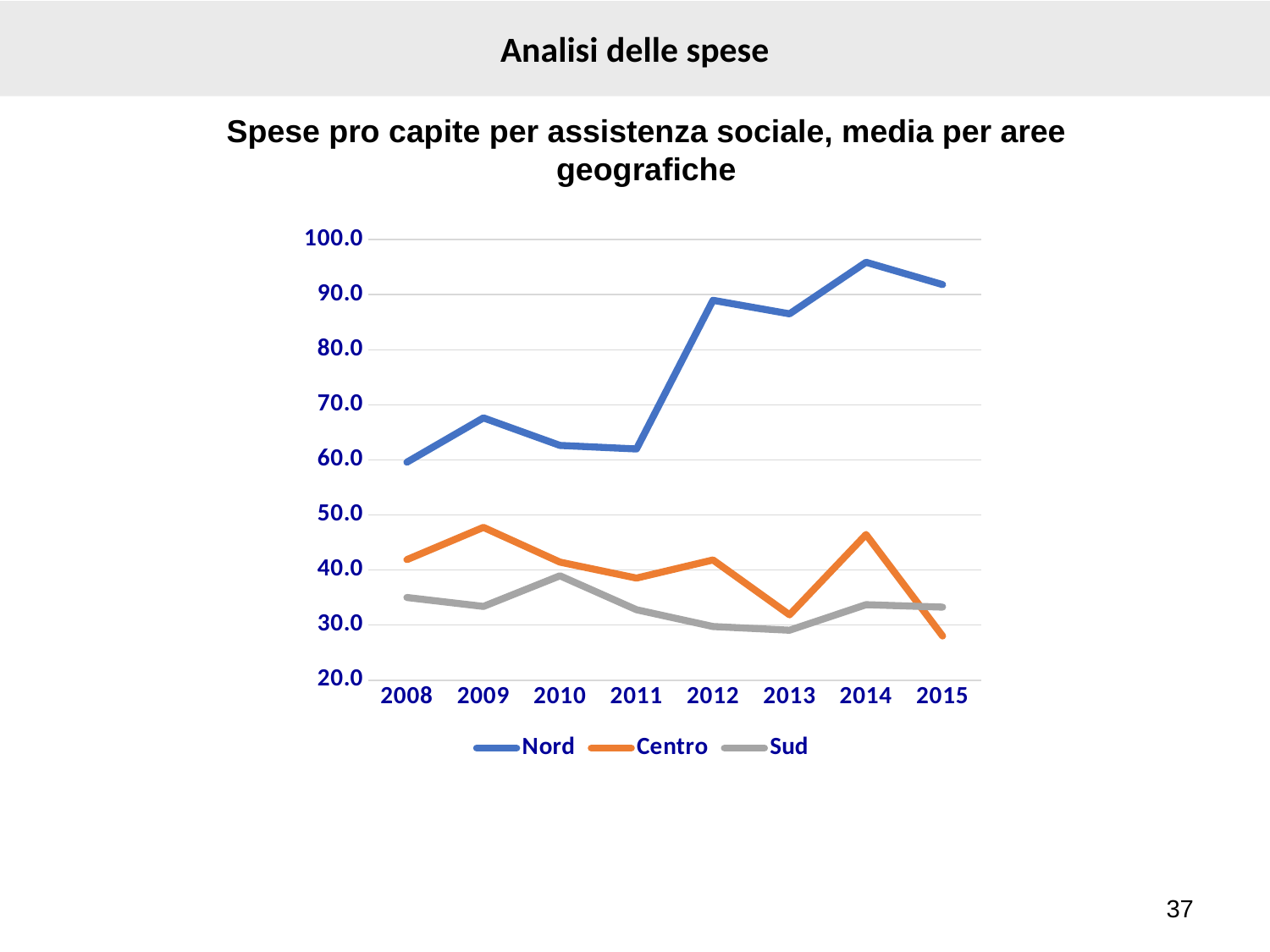
What colour is the line for the Sud series? grey What kind of chart is shown on the slide? line chart In which year does the Centro series reach its lowest value? 2015 Does the Nord series overall rise or fall from 2008 to 2015? rise Is the value for Nord in 2012 greater or less than 80.0? greater Is the value for Centro in 2015 greater or less than 30.0? less How many years are shown on the x axis? 8 How many series does the legend list? 3 In which year does the Nord series reach its highest value? 2014 Is the value for Nord in 2014 greater or less than 90.0? greater In which year does the Sud series reach its highest value? 2010 In 2014, which series has the larger value, Centro or Sud? Centro